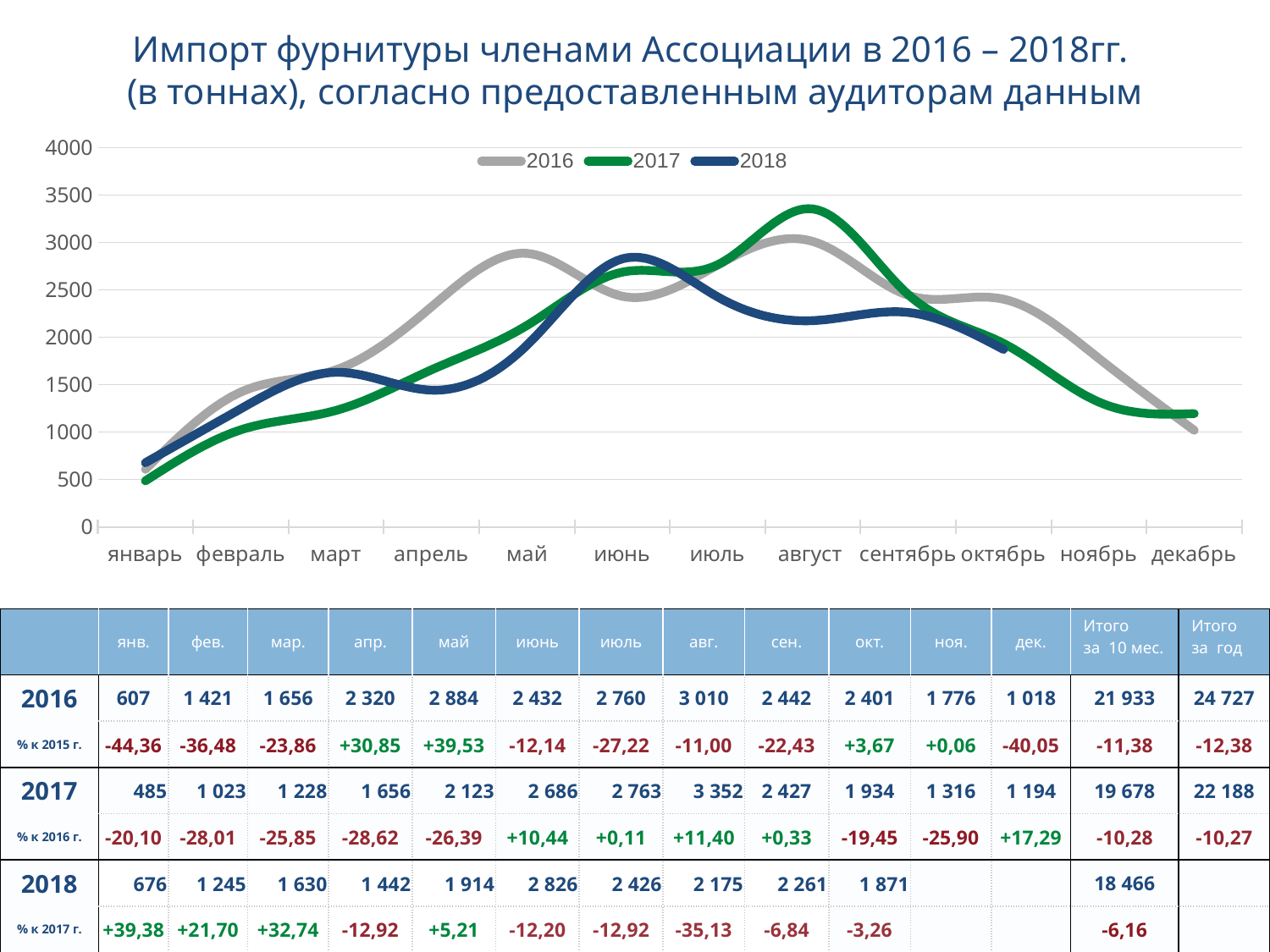
How many series does the chart legend list? 3 What is the difference between the May 2016 value (2 884) and the May 2017 value (2 123)? 761 What is the total import volume for the full year 2016 (Итого за год)? 24 727 What kind of chart is shown on the slide? line chart What was the import volume in August 2017 (август, 2017)? 3 352 How many months of data are plotted for the 2018 series? 10 What was the import volume in October 2018 (окт., 2018)? 1 871 In which month was the 2016 import volume highest? август Which year had the larger import volume in June: 2016 or 2018? 2018 Does the 2016 line rise or fall from August to December? fall In which month was the 2017 import volume lowest? январь Is the value for December 2016 greater or less than 1500? less